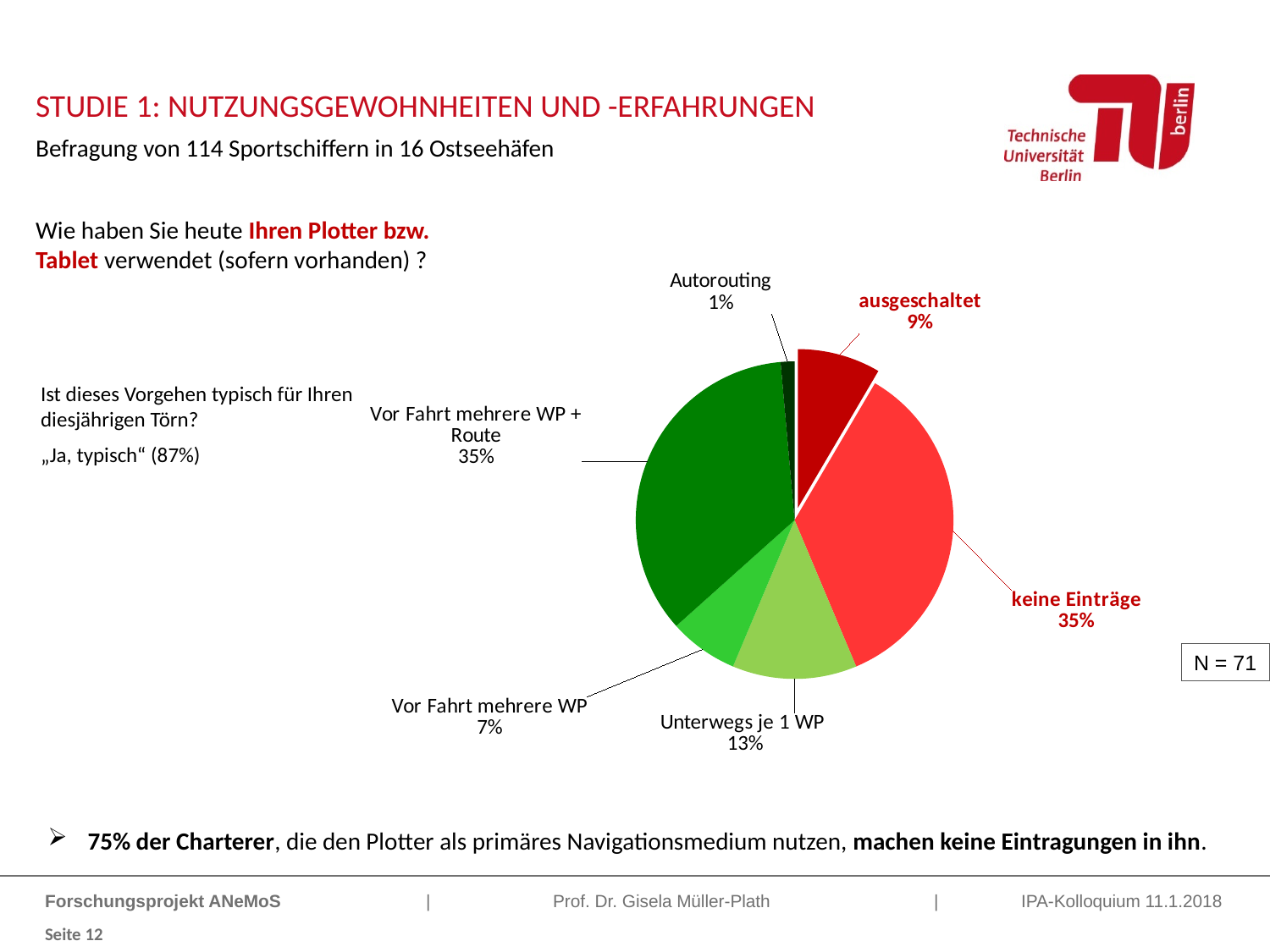
Which is larger, the share for "Unterwegs je 1 WP" or the share for "Autorouting"? Unterwegs je 1 WP What share of the pie does "keine Einträge" represent? 35% What is the value shown for "Unterwegs je 1 WP"? 13% What kind of chart is shown on the slide? pie chart What sample size (N) is stated next to the pie chart? N = 71 What is the value shown for "ausgeschaltet"? 9% Which category has the smallest share of the pie? Autorouting What is the difference in percentage points between "Unterwegs je 1 WP" and "Vor Fahrt mehrere WP"? 6 What is the difference in percentage points between "keine Einträge" and "ausgeschaltet"? 26 How many slices does the pie chart have? 6 What is the value shown for "Vor Fahrt mehrere WP + Route"? 35% Which is larger, the share for "ausgeschaltet" or the share for "Vor Fahrt mehrere WP"? ausgeschaltet